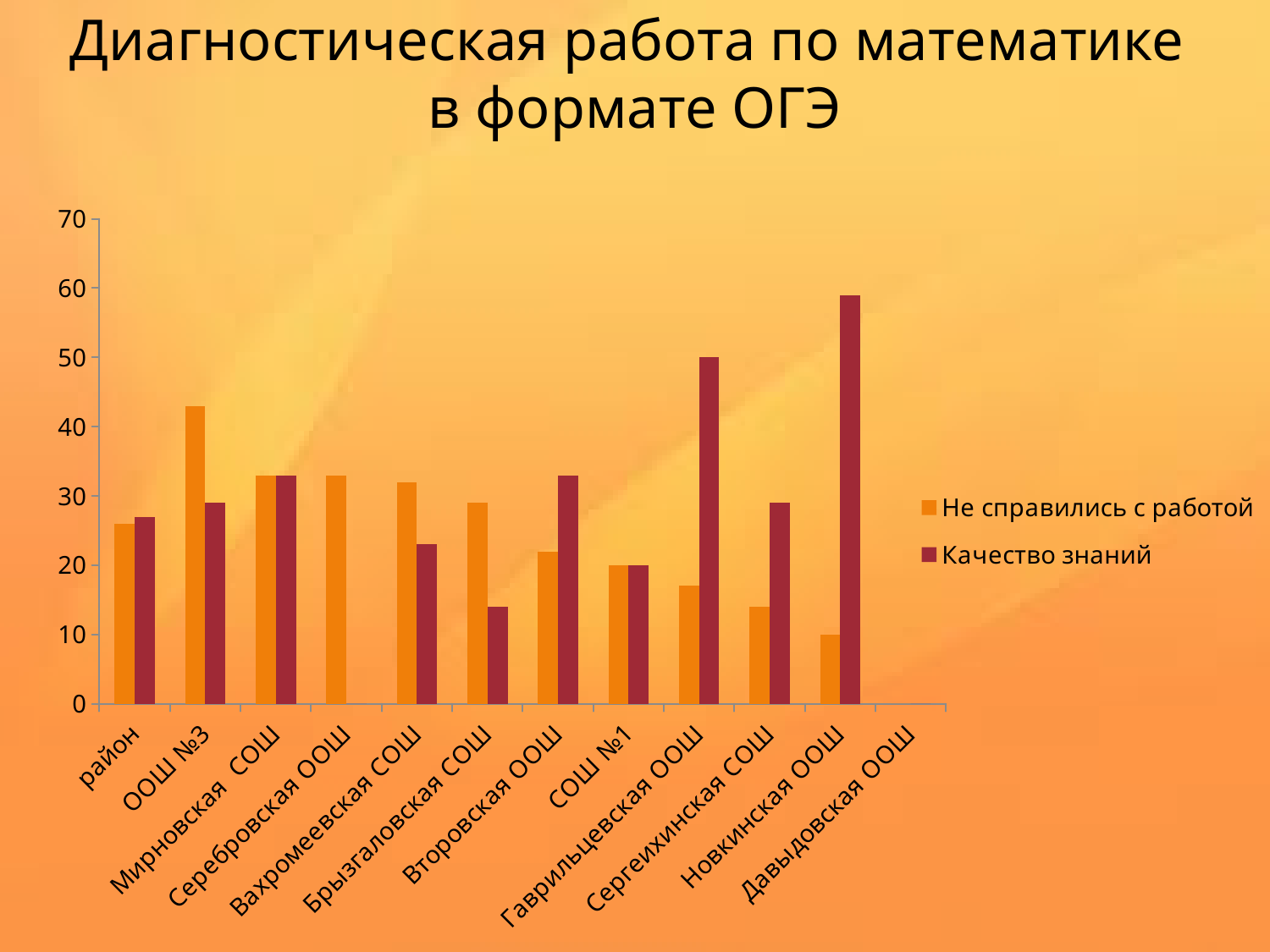
Which category has the highest value for Качество знаний? Новкинская ООШ What is the value of Не справились с работой for СОШ №1? 20 For Гаврильцевская ООШ, which is larger: Не справились с работой or Качество знаний? Качество знаний How many categories are shown on the x axis? 12 What is the value of Качество знаний for Гаврильцевская ООШ? 50 What is the title of the chart on the slide? Диагностическая работа по математике в формате ОГЭ Which category has the highest value for Не справились с работой? ООШ №3 Is the value of Качество знаний for Новкинская ООШ greater or less than 50? greater How many series does the legend list? 2 Is the value of Не справились с работой for ООШ №3 greater or less than 40? greater Is the value of Качество знаний for Брызгаловская СОШ greater or less than 20? less What kind of chart is shown on the slide? bar chart